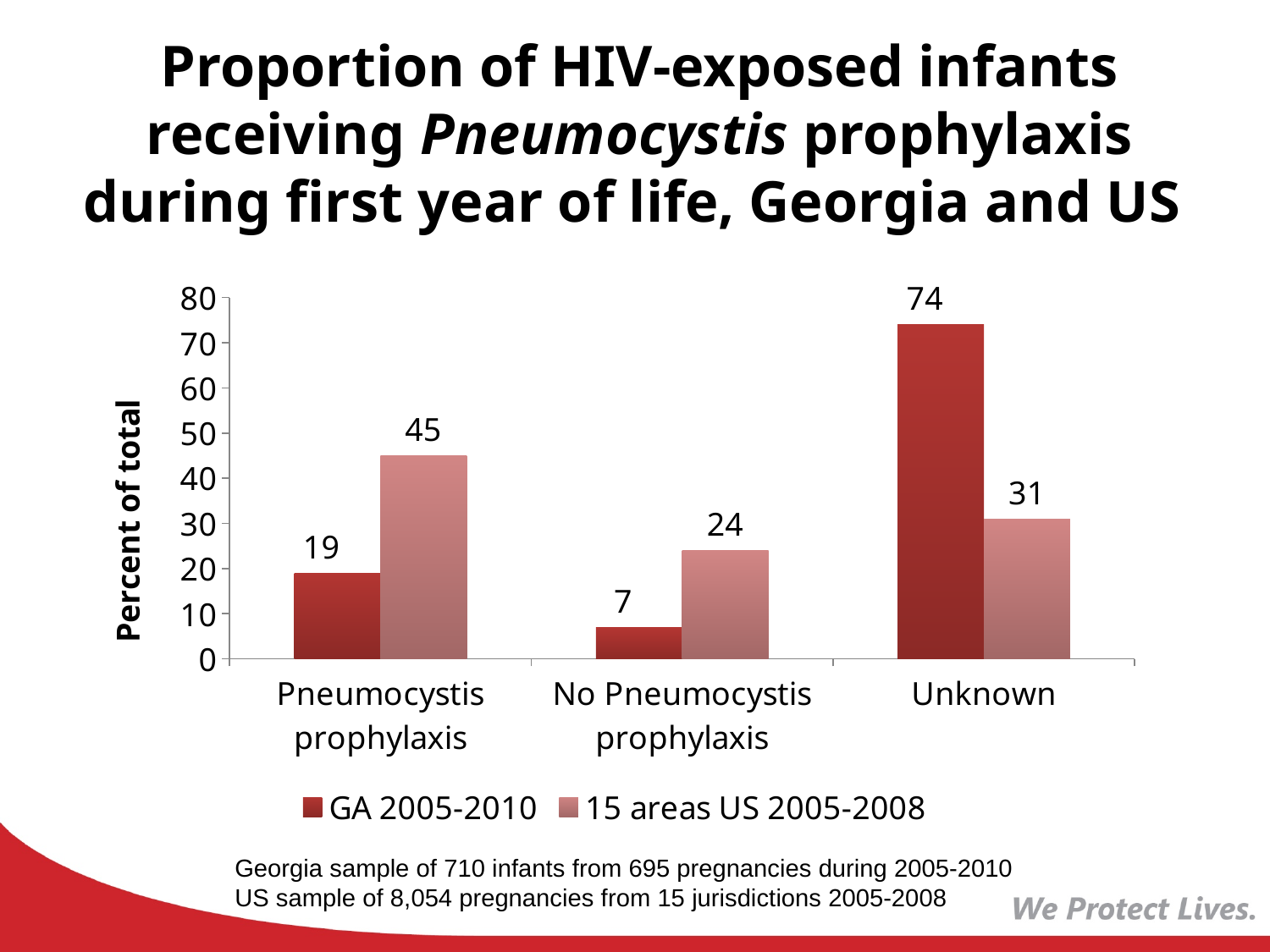
In the Unknown category, which series has the larger value, GA 2005-2010 or 15 areas US 2005-2008? GA 2005-2010 What kind of chart is shown on the slide? Bar chart How many categories are shown on the x axis? 3 What is the value for GA 2005-2010 in the No Pneumocystis prophylaxis category? 7 What is the difference between the 15 areas US 2005-2008 and GA 2005-2010 values in the Pneumocystis prophylaxis category? 26 Is the value for 15 areas US 2005-2008 in the No Pneumocystis prophylaxis category greater or less than 20? greater Which category has the highest value for GA 2005-2010? Unknown Which category has the lowest value for 15 areas US 2005-2008? No Pneumocystis prophylaxis What is the value for 15 areas US 2005-2008 in the Unknown category? 31 What is the label of the y axis? Percent of total What is the value for GA 2005-2010 in the Pneumocystis prophylaxis category? 19 How many series does the legend list? 2